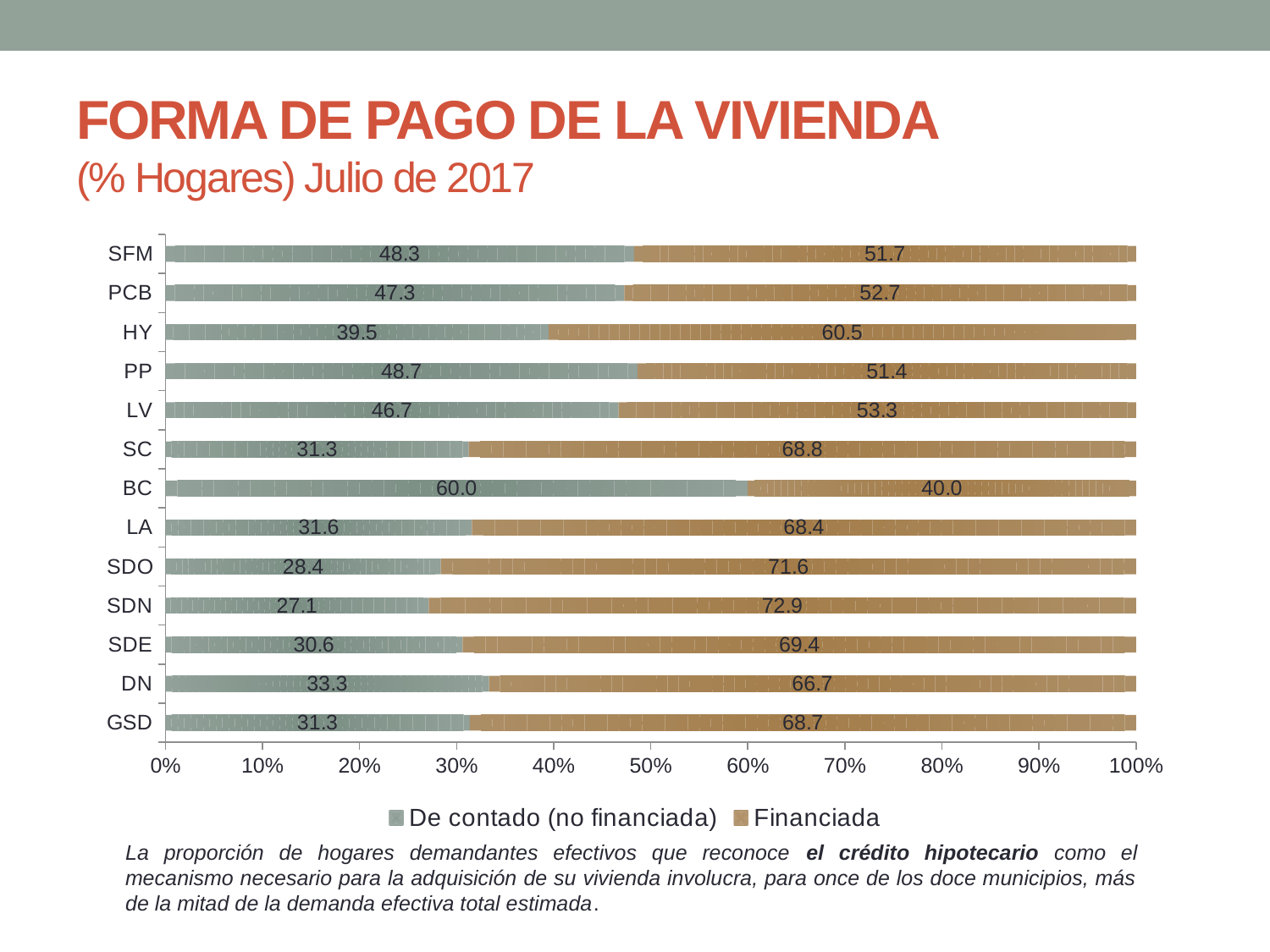
Which category has the highest 'De contado (no financiada)' value? BC What is the 'Financiada' value for SDO? 71.6 What is the difference between the 'Financiada' and 'De contado (no financiada)' values for BC? 20.0 What is the 'De contado (no financiada)' value for HY? 39.5 Which category has the lowest 'Financiada' value? BC How many series does the legend list? 2 What is the 'De contado (no financiada)' value for GSD? 31.3 What type of chart is shown on the slide? Stacked bar chart How many categories (municipalities) are plotted on the chart? 13 What are the two series named in the legend? De contado (no financiada) and Financiada Which is larger, the 'De contado (no financiada)' value for HY or for LV? LV Which category has the lowest 'De contado (no financiada)' value? SDN